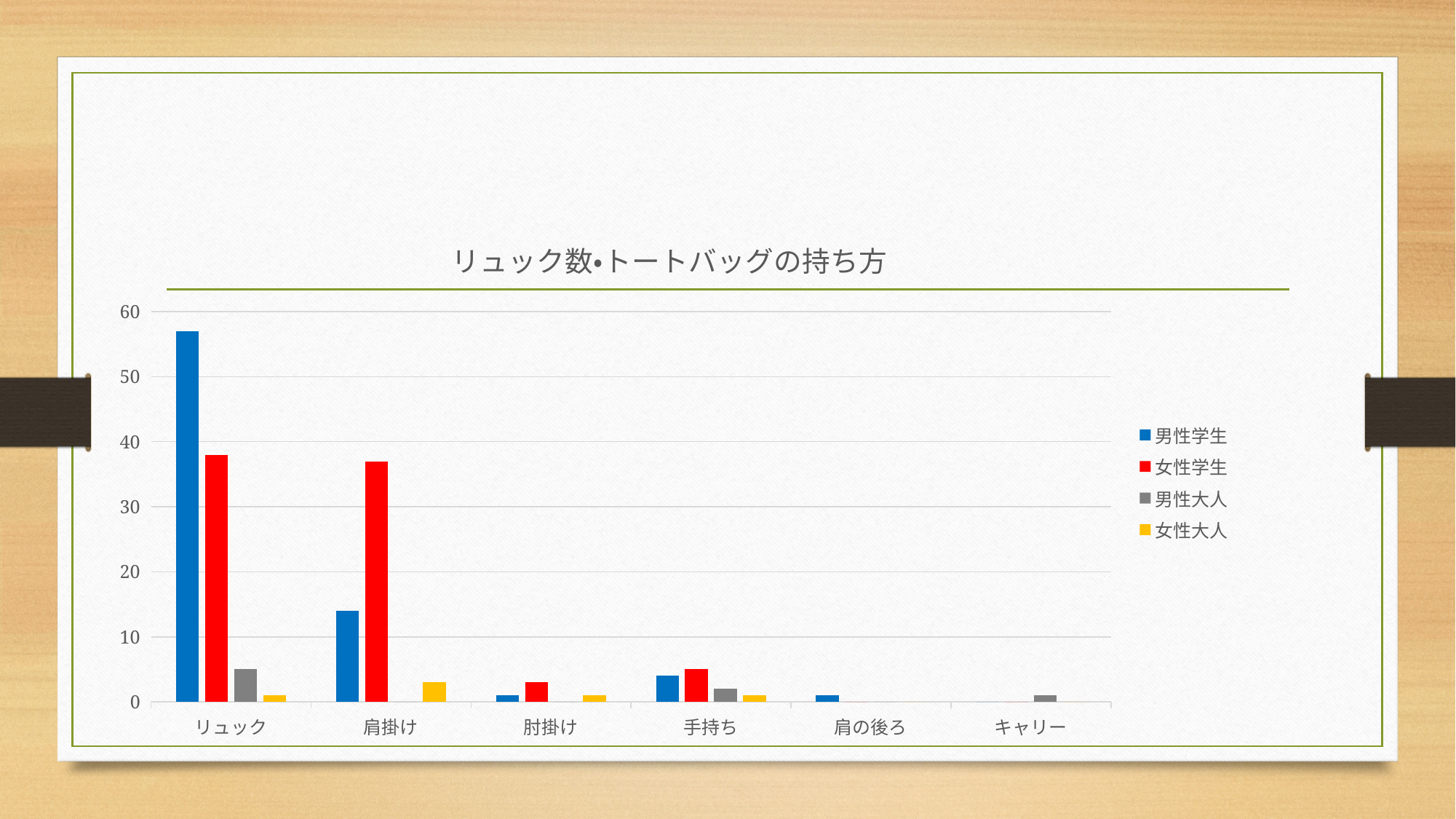
How many categories are shown on the x axis of the chart? 6 In the リュック category, which is larger: 男性学生 or 女性学生? 男性学生 Is the value for 男性学生 in the リュック category greater or less than 50? greater Is the value for 女性学生 in the リュック category greater or less than 40? less Which category has the highest value for 男性学生? リュック Which colour represents 女性大人 in the chart's legend? yellow What is the title of the chart? リュック数•トートバッグの持ち方 How many series does the chart's legend list? 4 In the 肩掛け category, which is larger: 男性学生 or 女性学生? 女性学生 What kind of chart is shown on the slide? bar chart Is the value for 男性学生 in the 肩掛け category greater or less than 10? greater